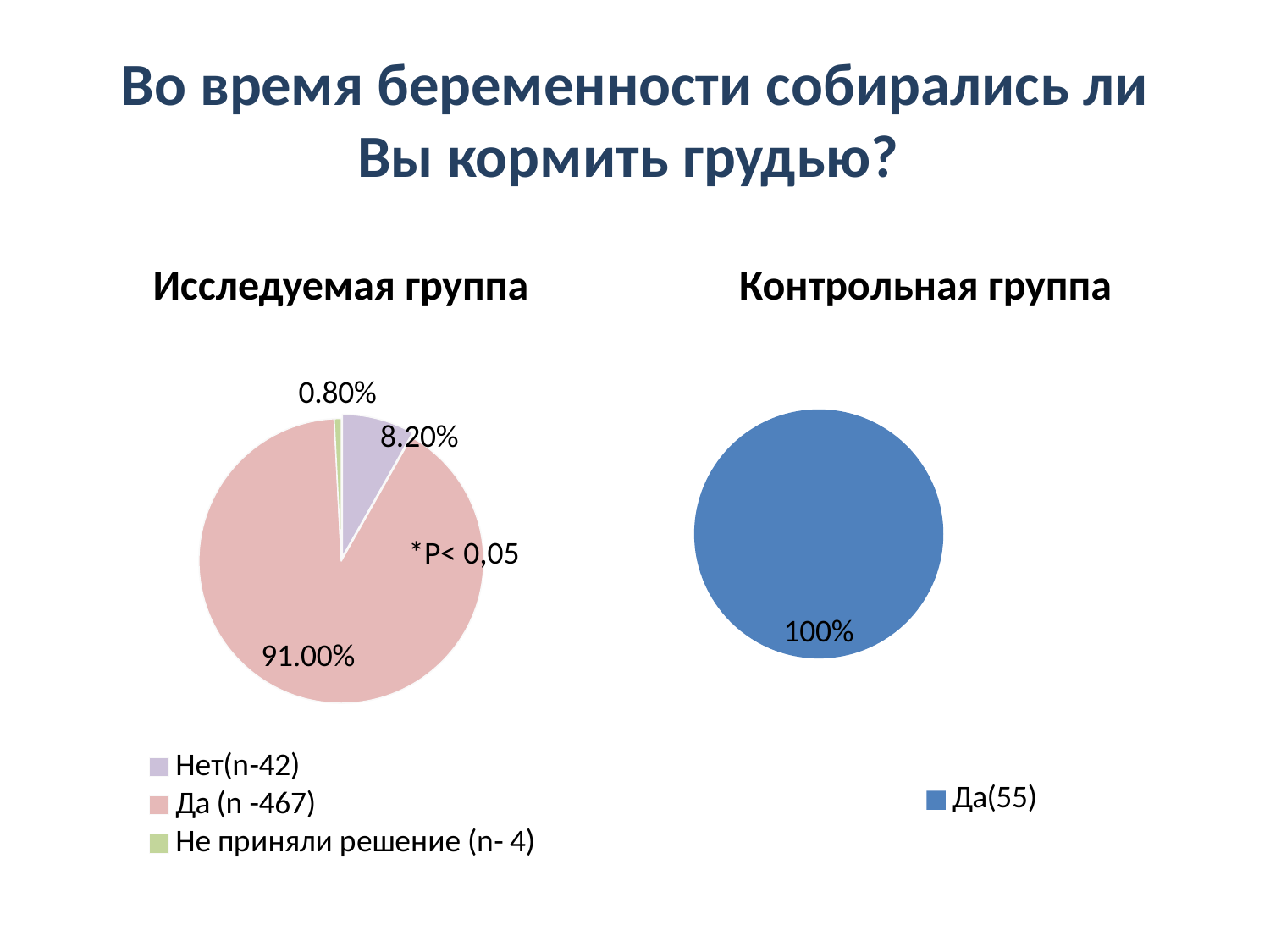
In the 'Исследуемая группа' chart, what is the difference in percentage points between the 'Да (n -467)' and 'Нет(n-42)' slices? 82.80% In the 'Исследуемая группа' chart, which slice is larger: 'Нет(n-42)' or 'Не приняли решение (n- 4)'? Нет(n-42) How many categories does the legend of the 'Контрольная группа' chart list? 1 In the 'Исследуемая группа' chart, what share of the pie is labelled for 'Не приняли решение (n- 4)'? 0.80% In the 'Исследуемая группа' chart, which category has the largest slice? Да (n -467) What type of chart is the 'Контрольная группа' chart? Pie chart In the 'Контрольная группа' chart, what share of the pie is labelled for 'Да(55)'? 100% In the 'Исследуемая группа' chart, what share of the pie is labelled for 'Да (n -467)'? 91.00% What is the title of the chart on the left side of the slide? Исследуемая группа How many categories does the legend of the 'Исследуемая группа' chart list? 3 In the 'Исследуемая группа' chart, which category has the smallest slice? Не приняли решение (n- 4)